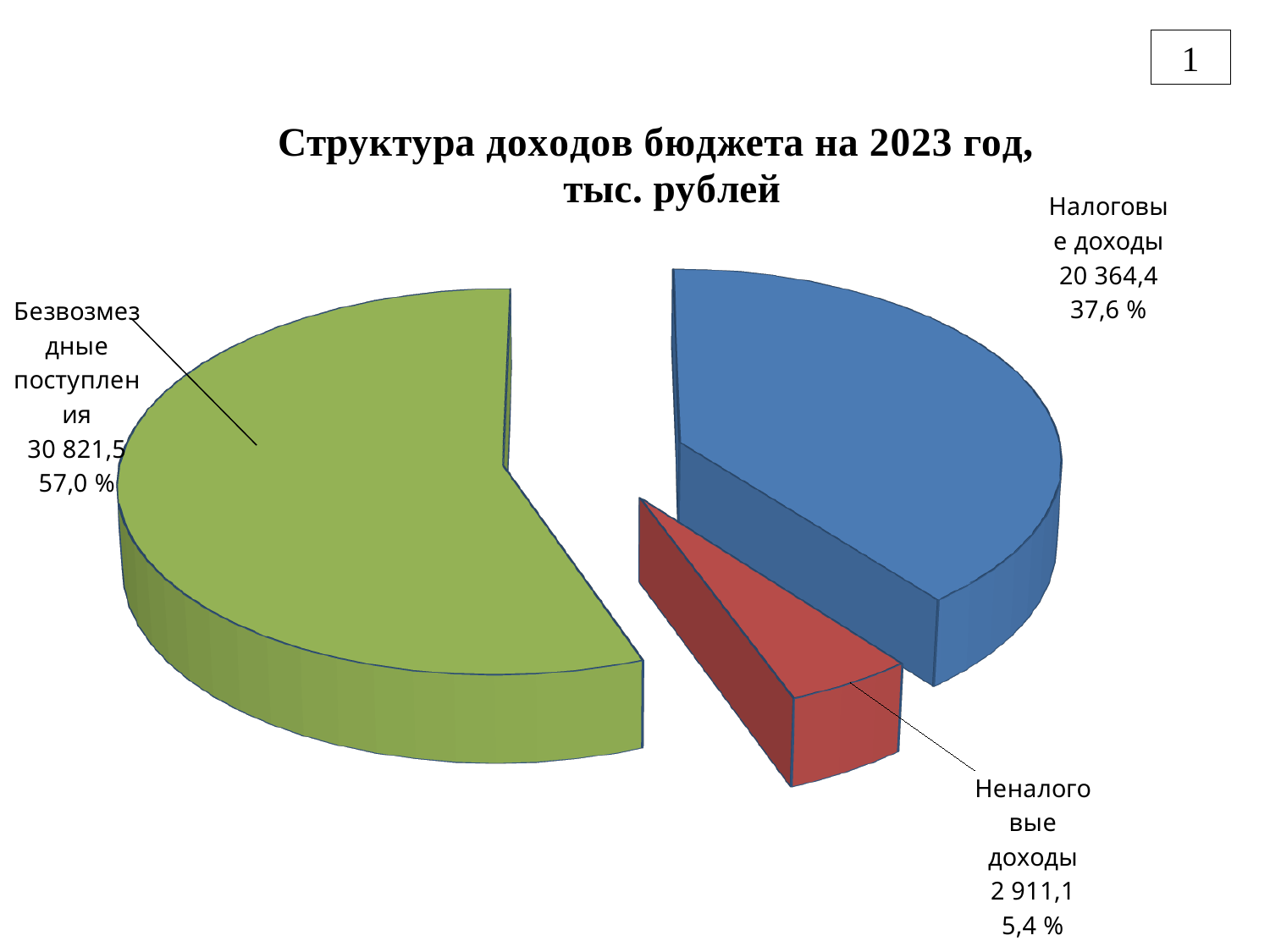
What is the title of the chart? Структура доходов бюджета на 2023 год, тыс. рублей What is the value for Налоговые доходы? 20 364,4 What is the difference between Безвозмездные поступления and Налоговые доходы? 10 457,1 What is the value for Неналоговые доходы? 2 911,1 What is the value for Безвозмездные поступления? 30 821,5 Which is larger, Налоговые доходы or Неналоговые доходы? Налоговые доходы Which category has the largest slice? Безвозмездные поступления What share of the pie does Налоговые доходы represent? 37,6 % What type of chart is shown on the slide? Pie chart How many slices does the pie chart have? 3 What share of the pie does Неналоговые доходы represent? 5,4 % Which category has the smallest slice? Неналоговые доходы